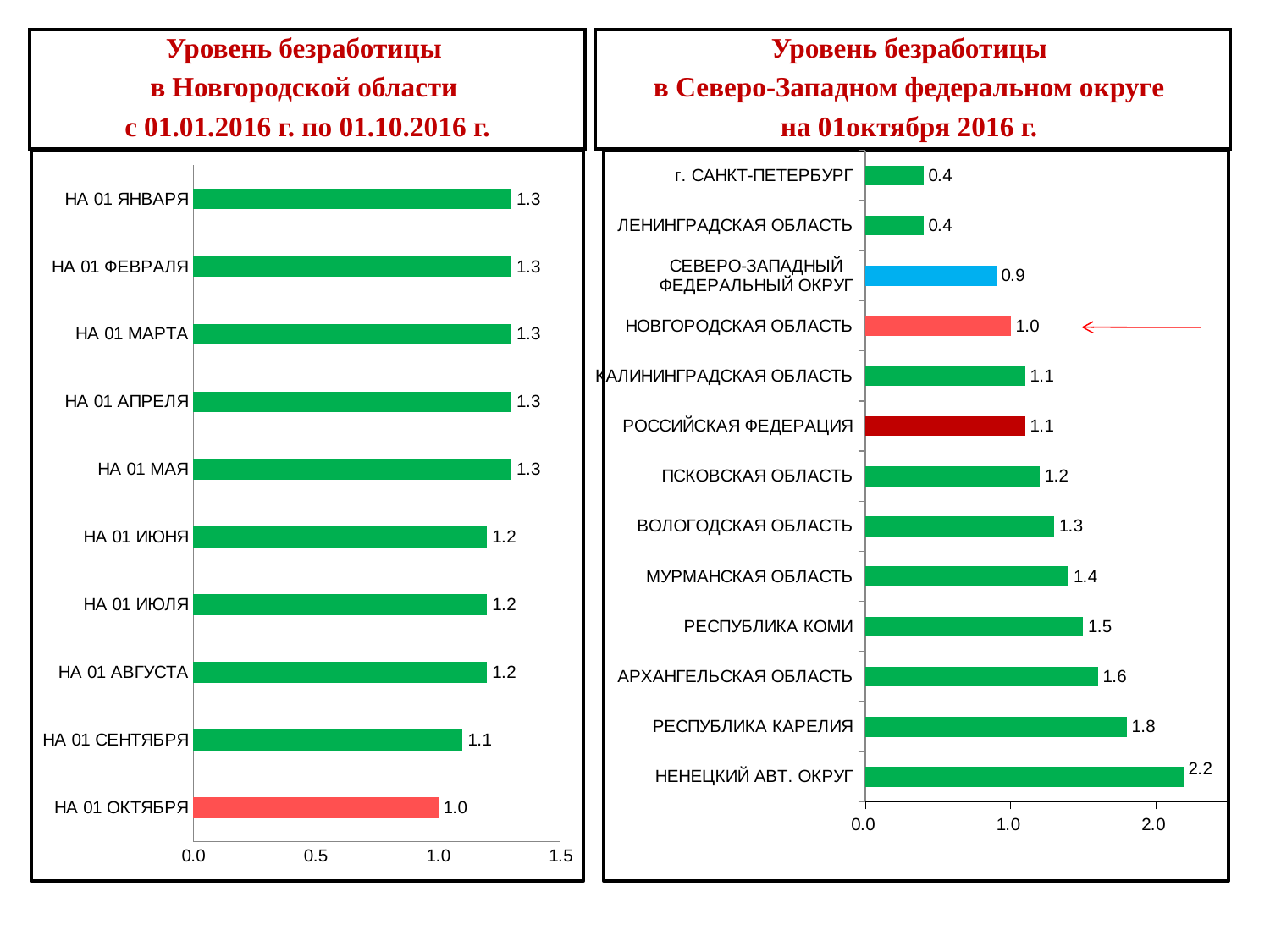
In the right chart (Уровень безработицы в Северо-Западном федеральном округе), what is the value for НОВГОРОДСКАЯ ОБЛАСТЬ? 1.0 In the left chart (Уровень безработицы в Новгородской области), how many categories are plotted? 10 In the left chart (Уровень безработицы в Новгородской области), what is the value for НА 01 ОКТЯБРЯ? 1.0 In the right chart (Уровень безработицы в Северо-Западном федеральном округе), which is larger, the value for МУРМАНСКАЯ ОБЛАСТЬ or the value for ПСКОВСКАЯ ОБЛАСТЬ? МУРМАНСКАЯ ОБЛАСТЬ In the right chart (Уровень безработицы в Северо-Западном федеральном округе), how many categories are plotted? 13 In the left chart (Уровень безработицы в Новгородской области), what is the difference between the values for НА 01 ЯНВАРЯ and НА 01 ОКТЯБРЯ? 0.3 In the right chart (Уровень безработицы в Северо-Западном федеральном округе), what is the difference between the values for НЕНЕЦКИЙ АВТ. ОКРУГ and РЕСПУБЛИКА КАРЕЛИЯ? 0.4 In the left chart (Уровень безработицы в Новгородской области), which category has the lowest value? НА 01 ОКТЯБРЯ What kind of chart is the right chart (Уровень безработицы в Северо-Западном федеральном округе)? bar chart In the left chart (Уровень безработицы в Новгородской области), what is the value for НА 01 СЕНТЯБРЯ? 1.1 In the right chart (Уровень безработицы в Северо-Западном федеральном округе), which category has the highest value? НЕНЕЦКИЙ АВТ. ОКРУГ In the left chart (Уровень безработицы в Новгородской области), do the values rise or fall from НА 01 ЯНВАРЯ to НА 01 ОКТЯБРЯ? fall